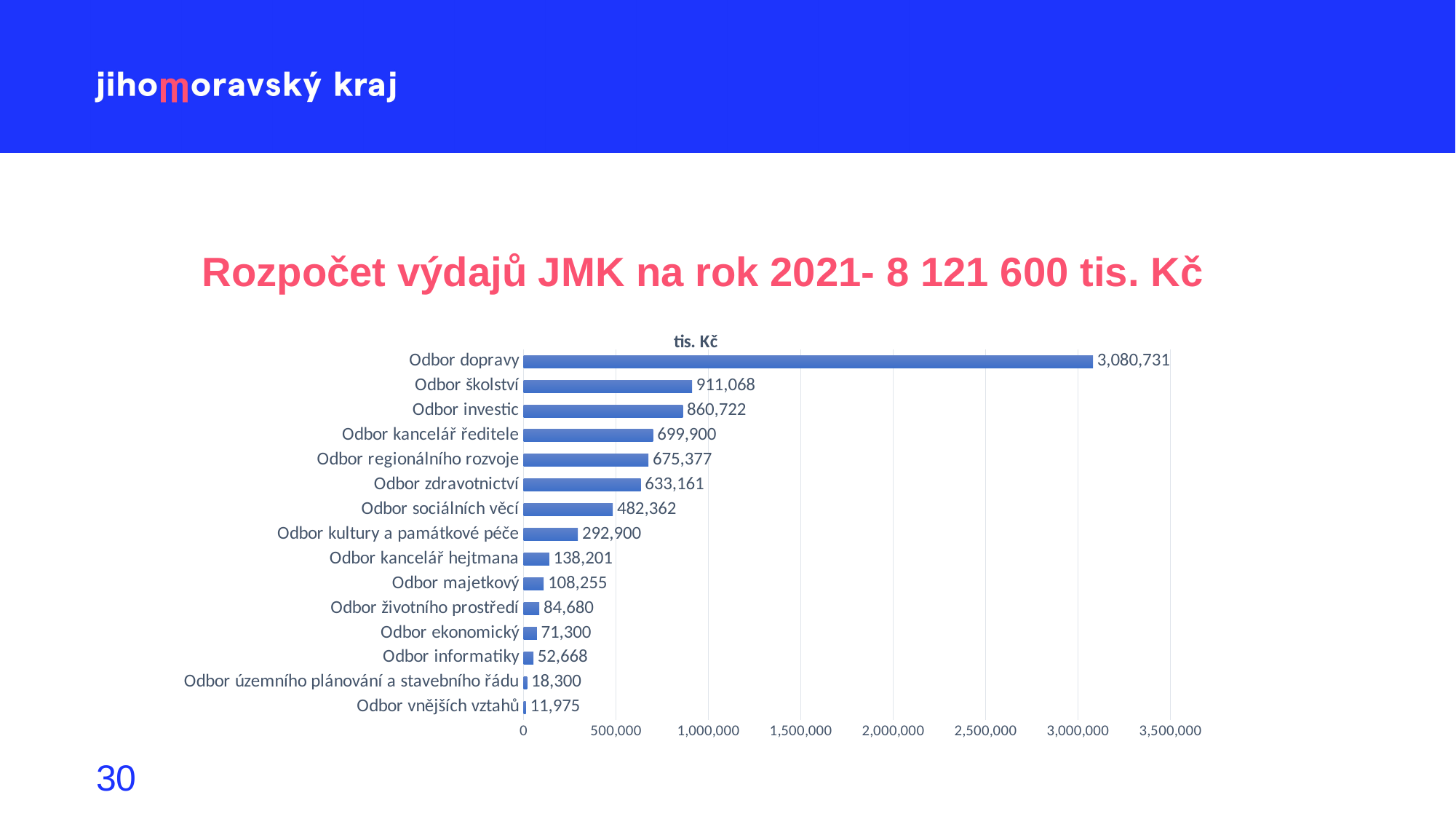
Which category has the lowest value? Odbor vnějších vztahů What is the difference between the values for Odbor školství and Odbor investic? 50,346 Which category has the highest value? Odbor dopravy What is the difference between the values for Odbor kancelář hejtmana and Odbor majetkový? 29,946 What is the title of the chart? tis. Kč Is the value for Odbor sociálních věcí greater or less than 500,000? less Which is larger, the value for Odbor kultury a památkové péče or the value for Odbor sociálních věcí? Odbor sociálních věcí What is the value for Odbor dopravy? 3,080,731 What is the value for Odbor informatiky? 52,668 What is the value for Odbor zdravotnictví? 633,161 How many categories are shown in the chart? 15 What kind of chart is shown on the slide? bar chart